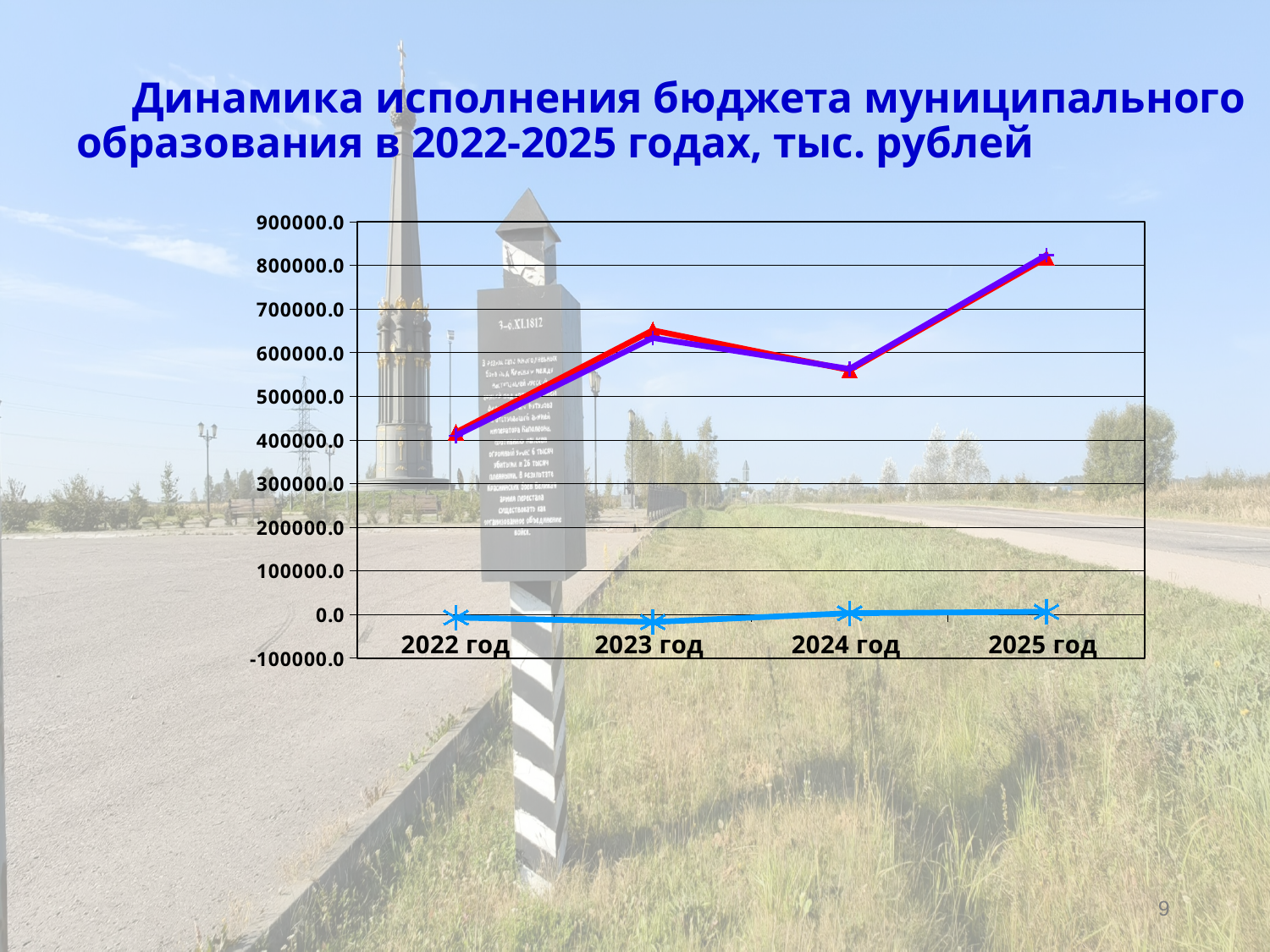
How many lines are plotted on the chart? 3 Is the value of the red line for 2022 год greater or less than 500000.0? less In which year does the red line have its lowest value? 2022 год Is the value of the red line for 2024 год greater or less than 600000.0? less For the red line, which year has the larger value: 2023 год or 2024 год? 2023 год How many year categories are shown on the x axis of the chart? 4 What kind of chart is shown on the slide? line chart Is the value of the light blue line for 2025 год greater or less than 100000.0? less Does the red line rise or fall from 2024 год to 2025 год? rise In which year does the red line reach its highest value? 2025 год What is the title of the slide containing the chart? Динамика исполнения бюджета муниципального образования в 2022-2025 годах, тыс. рублей